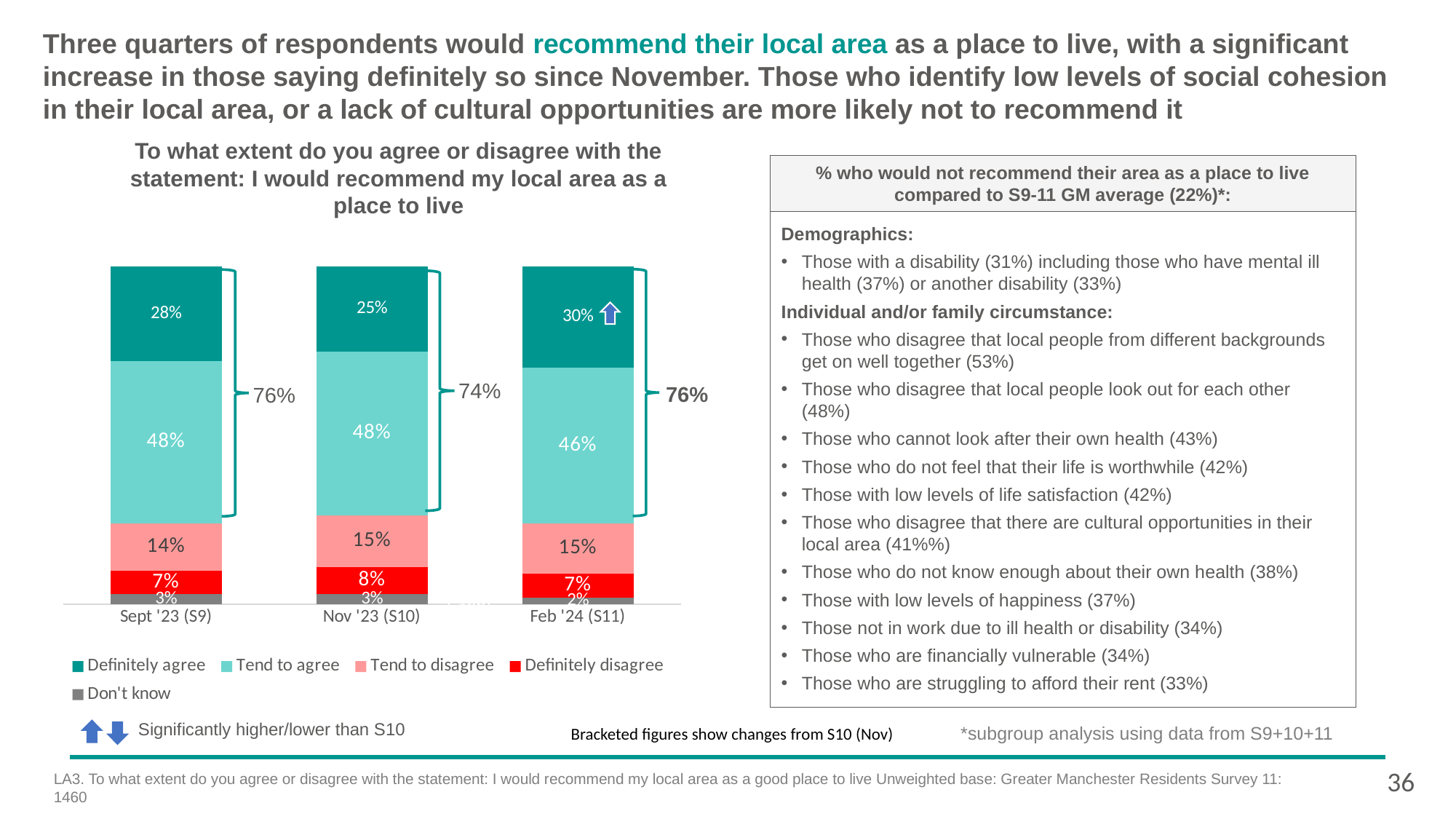
In which survey wave was the 'Definitely agree' share highest? Feb '24 (S11) What percentage of respondents said 'Don't know' in Feb '24 (S11)? 2% What percentage of respondents said 'Tend to agree' in Sept '23 (S9)? 48% What percentage of respondents said 'Definitely disagree' in Nov '23 (S10)? 8% How many survey waves are shown on the x axis of the chart? 3 How many series does the chart legend list? 5 What percentage of respondents said 'Definitely agree' in Feb '24 (S11)? 30% What type of chart is used to show the agreement with the statement about recommending the local area? Stacked bar chart In which survey wave was the 'Definitely agree' share lowest? Nov '23 (S10) Which is larger: the 'Tend to agree' share in Nov '23 (S10) or in Feb '24 (S11)? Nov '23 (S10) What is the combined share of 'Definitely agree' and 'Tend to agree' shown by the bracket for Nov '23 (S10)? 74% What is the difference in the 'Definitely agree' share between Feb '24 (S11) and Nov '23 (S10)? 5 percentage points